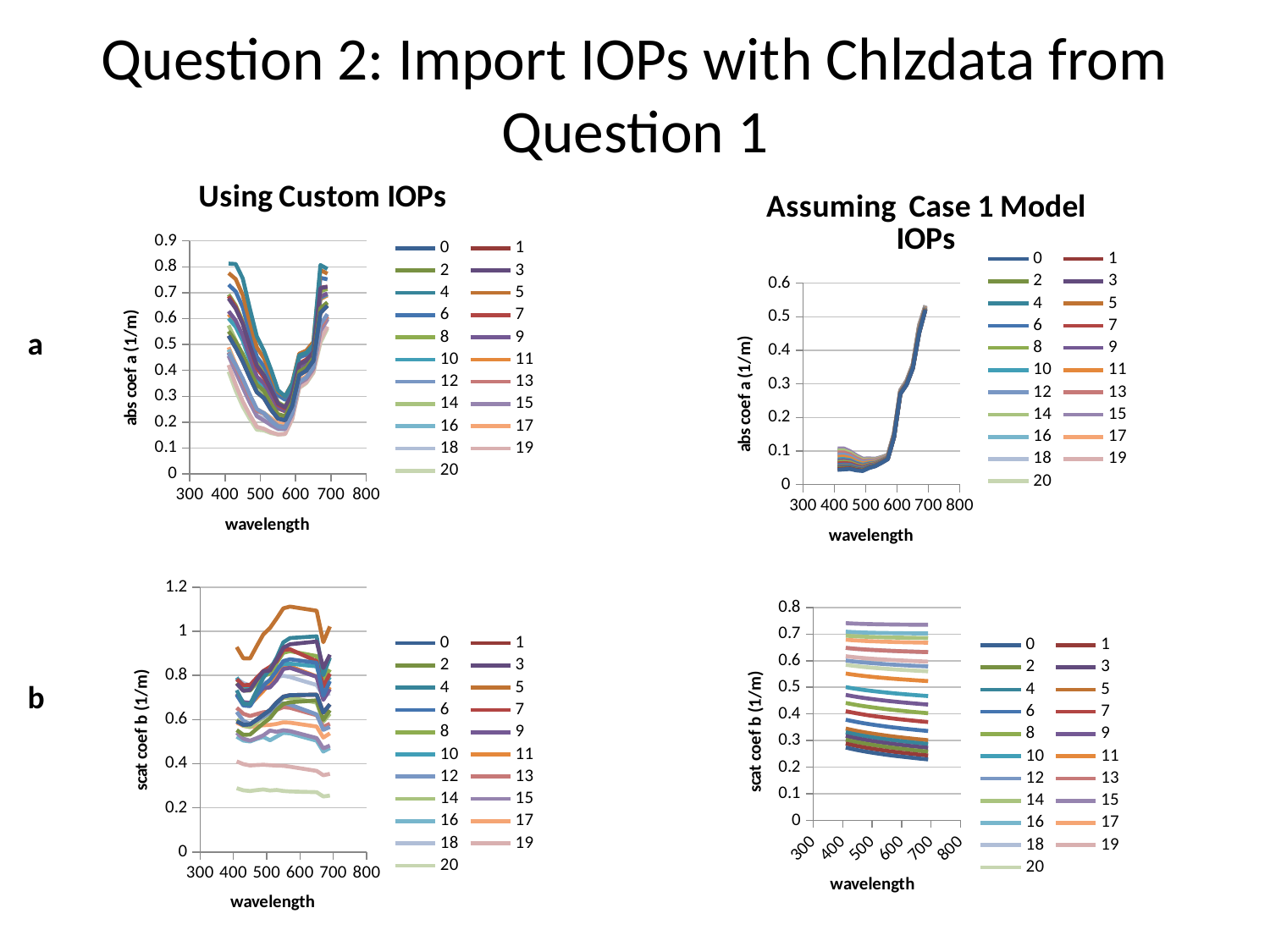
In the top-right chart (abs coef a, Assuming Case 1 Model IOPs), do the values rise or fall between wavelength 600 and 700? rise In the bottom-left chart (scat coef b, Using Custom IOPs), which series has the lowest values? 20 In the bottom-left chart (scat coef b, Using Custom IOPs), which series has the highest values? 5 What kind of chart is the top-left chart titled 'Using Custom IOPs'? line chart In the bottom-left chart (scat coef b, Using Custom IOPs), is the peak value of series 5 greater or less than 1? greater How many series does the legend of the top-right chart 'Assuming Case 1 Model IOPs' list? 21 In the bottom-right chart (scat coef b, Assuming Case 1 Model IOPs), do the values rise or fall as wavelength increases? fall What is the y-axis label of the bottom-left chart? scat coef b (1/m) In the bottom-right chart (scat coef b, Assuming Case 1 Model IOPs), is the value for series 15 greater or less than 0.7? greater In the top-right chart (abs coef a, Assuming Case 1 Model IOPs), is the value at wavelength 700 greater or less than 0.5? greater In the bottom-right chart (scat coef b, Assuming Case 1 Model IOPs), which series has the highest values? 15